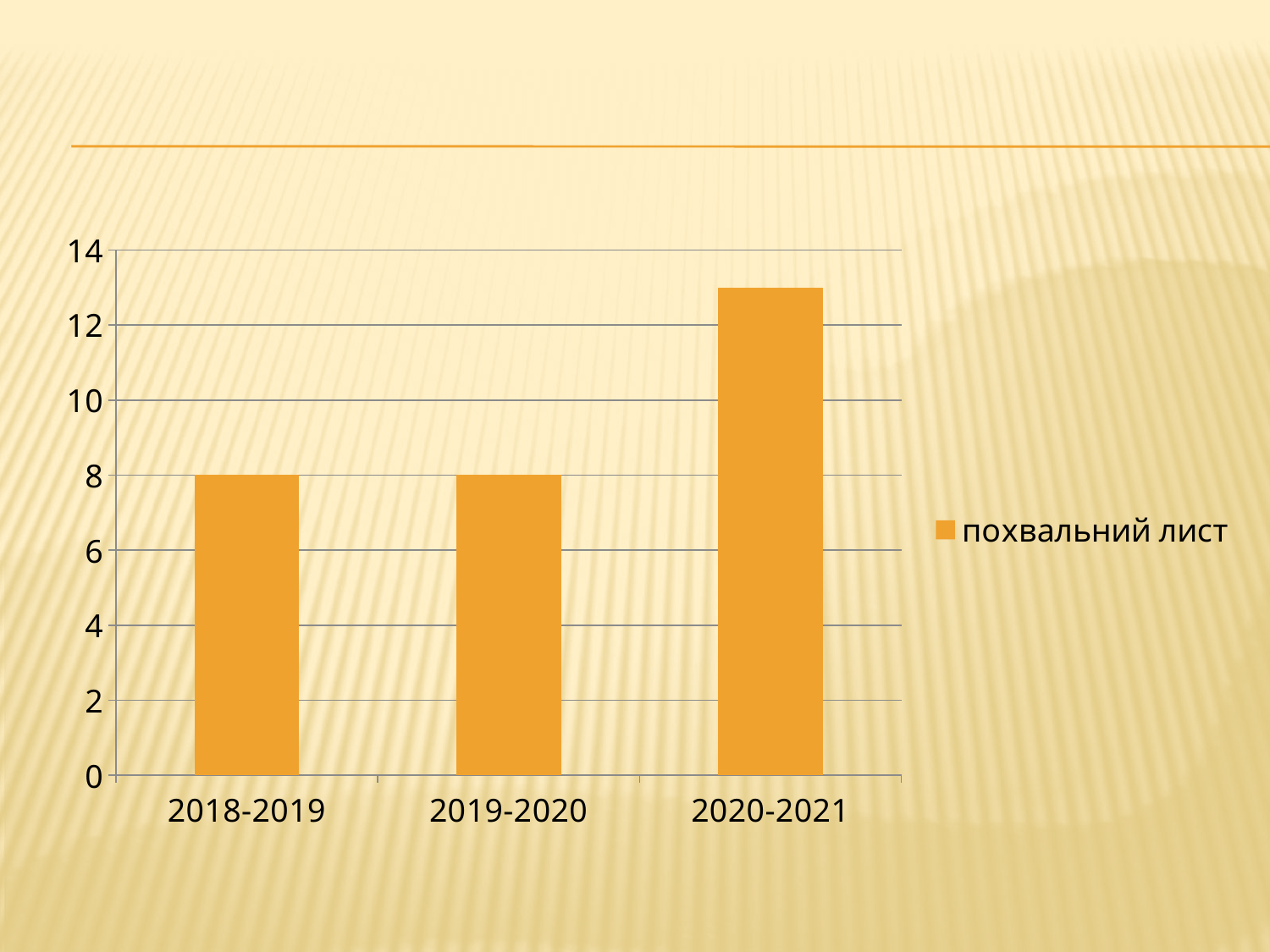
What is the value for 2019-2020? 8 What is the name of the series shown in the legend? похвальний лист Which category has the highest value? 2020-2021 Is the value for 2020-2021 greater or less than 14? less Is the value for 2020-2021 greater or less than 12? greater How many series does the legend list? 1 What is the difference between the values for 2018-2019 and 2019-2020? 0 What kind of chart is shown on the slide? bar chart Do the values rise or fall from 2019-2020 to 2020-2021? rise What is the value for 2018-2019? 8 Which is larger, the value for 2018-2019 or the value for 2020-2021? 2020-2021 How many categories are shown on the x axis? 3